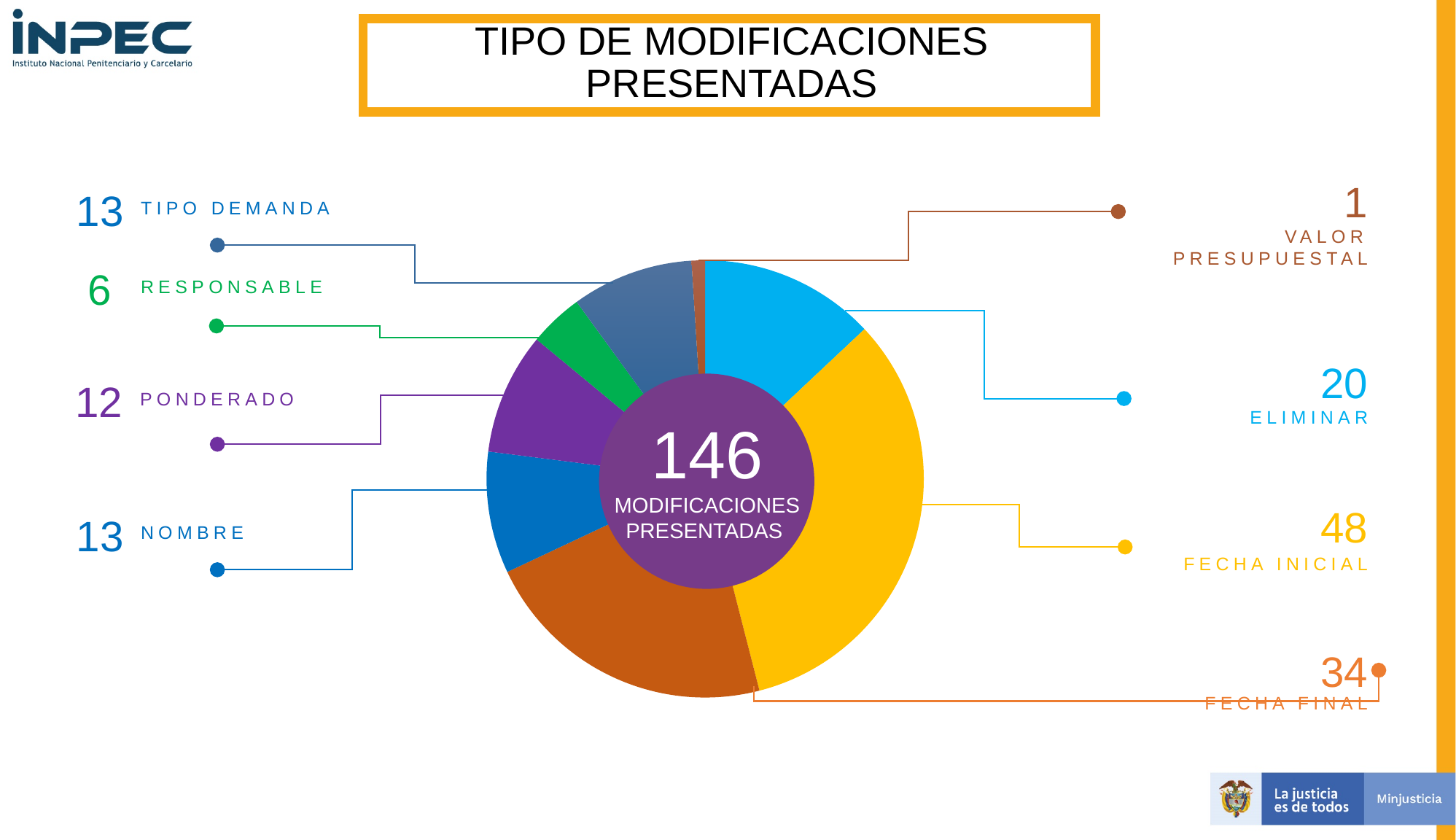
What is the difference between the values for FECHA INICIAL and FECHA FINAL? 14 What is the value shown for RESPONSABLE? 6 How many modifications are labelled for FECHA INICIAL? 48 Which category has the lowest value? VALOR PRESUPUESTAL What kind of chart is shown on the slide? pie chart How many categories are labelled around the pie chart? 8 What is the value shown for ELIMINAR? 20 What is the value shown for PONDERADO? 12 Which category has the highest value? FECHA INICIAL What is the value shown for VALOR PRESUPUESTAL? 1 What number is printed in the centre of the pie chart? 146 Which is larger, the value for ELIMINAR or the value for NOMBRE? ELIMINAR